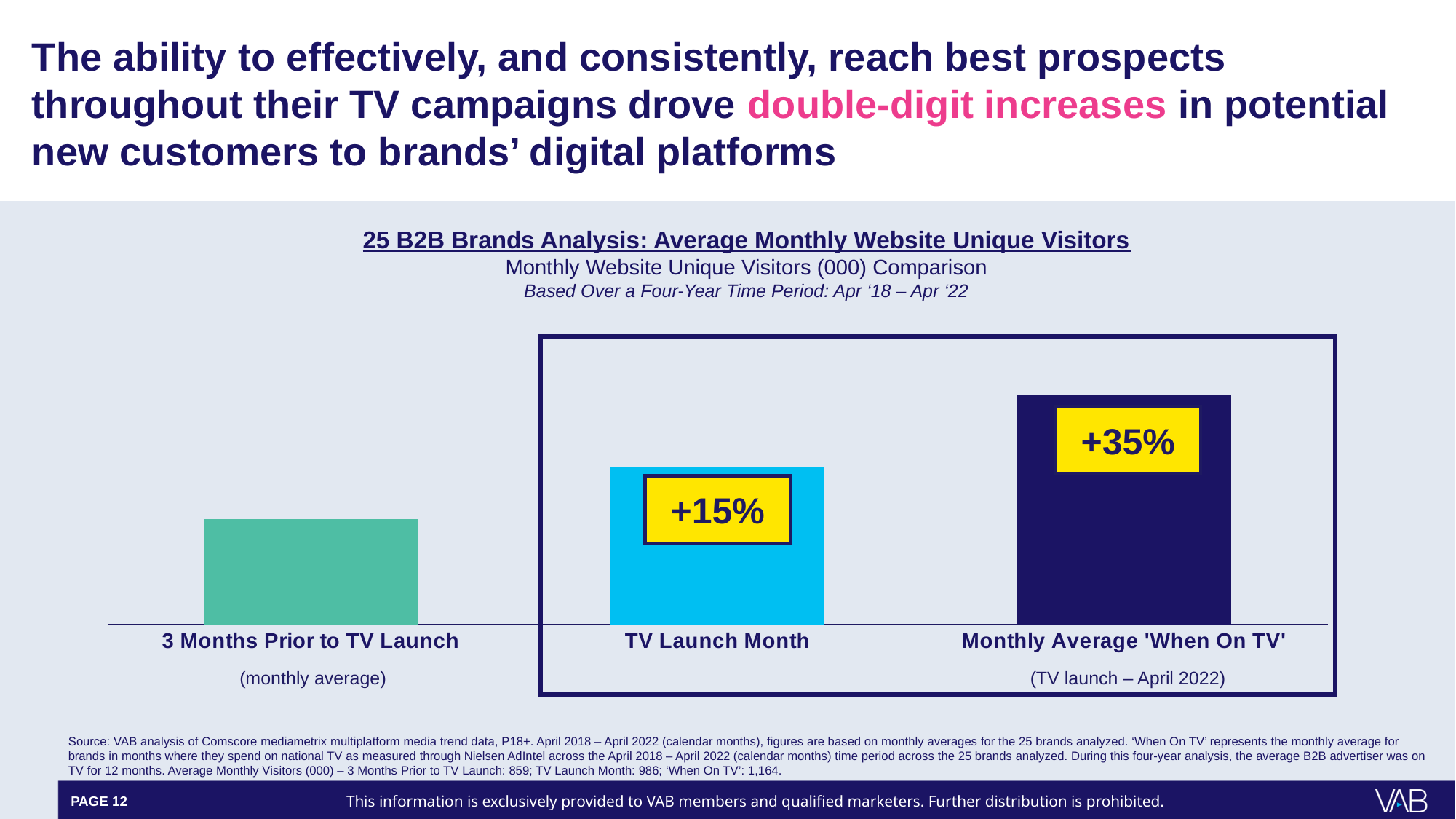
Which bar is taller: Monthly Average 'When On TV' or TV Launch Month? Monthly Average 'When On TV' What time period does the chart subtitle say the data is based over? Apr '18 – Apr '22 What kind of chart is shown on the slide? bar chart Which category has the shortest bar? 3 Months Prior to TV Launch What is the difference between the +35% label and the +15% label shown on the bars? 20 percentage points What percentage increase is labelled on the TV Launch Month bar? +15% How many bars are plotted in the chart? 3 Do the bars rise or fall from left to right across the chart? rise Which bar is taller: TV Launch Month or 3 Months Prior to TV Launch? TV Launch Month Which category has the tallest bar? Monthly Average 'When On TV' What percentage increase is labelled on the Monthly Average 'When On TV' bar? +35% What is the underlined title of the chart? 25 B2B Brands Analysis: Average Monthly Website Unique Visitors